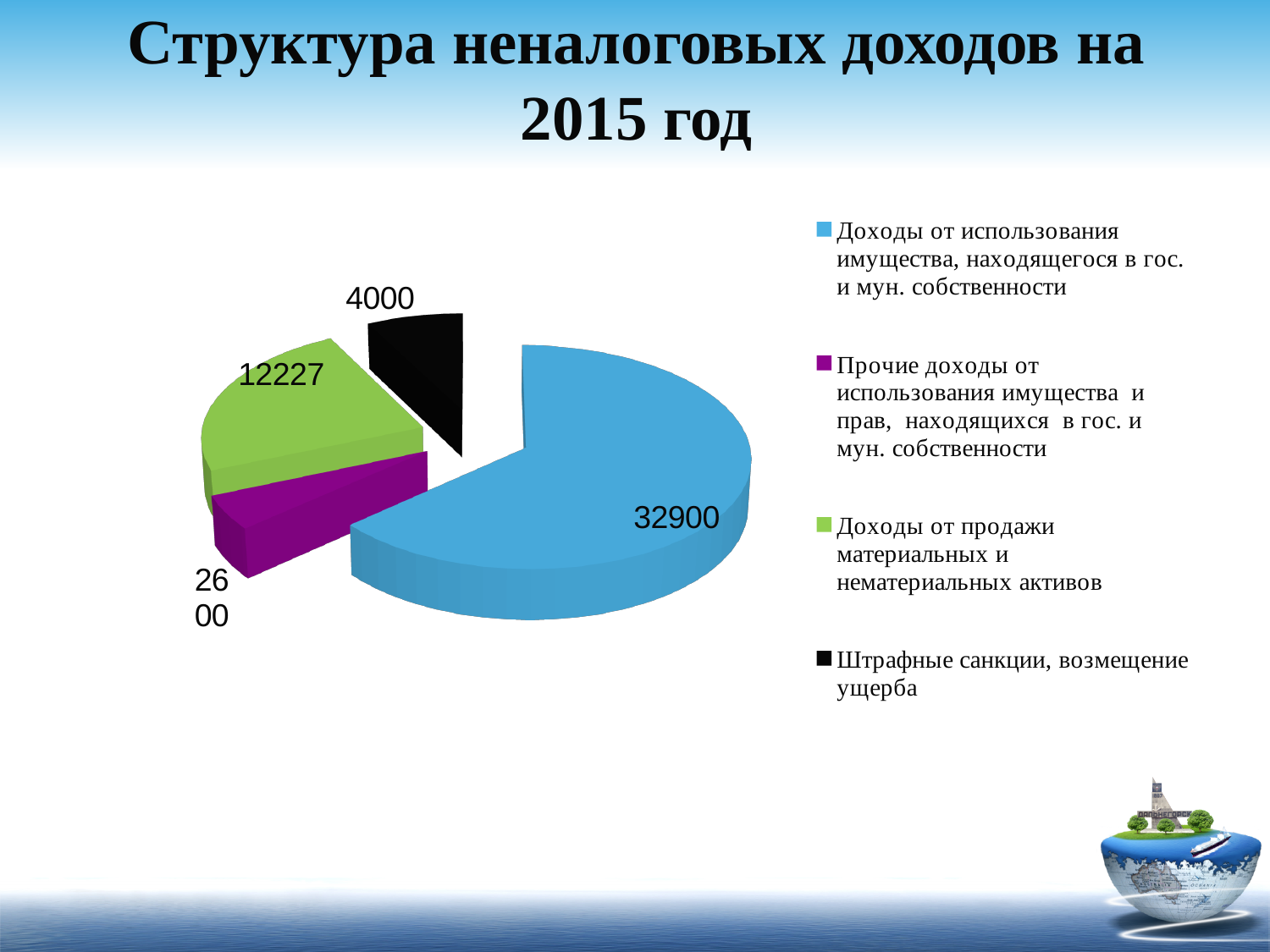
How many slices does the pie chart have? 4 What is the value for "Прочие доходы от использования имущества и прав, находящихся в гос. и мун. собственности"? 2600 What is the difference between the value for "Доходы от продажи материальных и нематериальных активов" and the value for "Штрафные санкции, возмещение ущерба"? 8227 What is the value for "Доходы от использования имущества, находящегося в гос. и мун. собственности"? 32900 What is the total of all the values shown on the pie chart? 51727 What is the value for "Доходы от продажи материальных и нематериальных активов"? 12227 Which is larger: the value for "Штрафные санкции, возмещение ущерба" or the value for "Прочие доходы от использования имущества и прав, находящихся в гос. и мун. собственности"? Штрафные санкции, возмещение ущерба Which category has the smallest slice of the pie? Прочие доходы от использования имущества и прав, находящихся в гос. и мун. собственности What colour is the slice for "Штрафные санкции, возмещение ущерба"? Black What kind of chart is shown on the slide? Pie chart Which category has the largest slice of the pie? Доходы от использования имущества, находящегося в гос. и мун. собственности What is the value for "Штрафные санкции, возмещение ущерба"? 4000